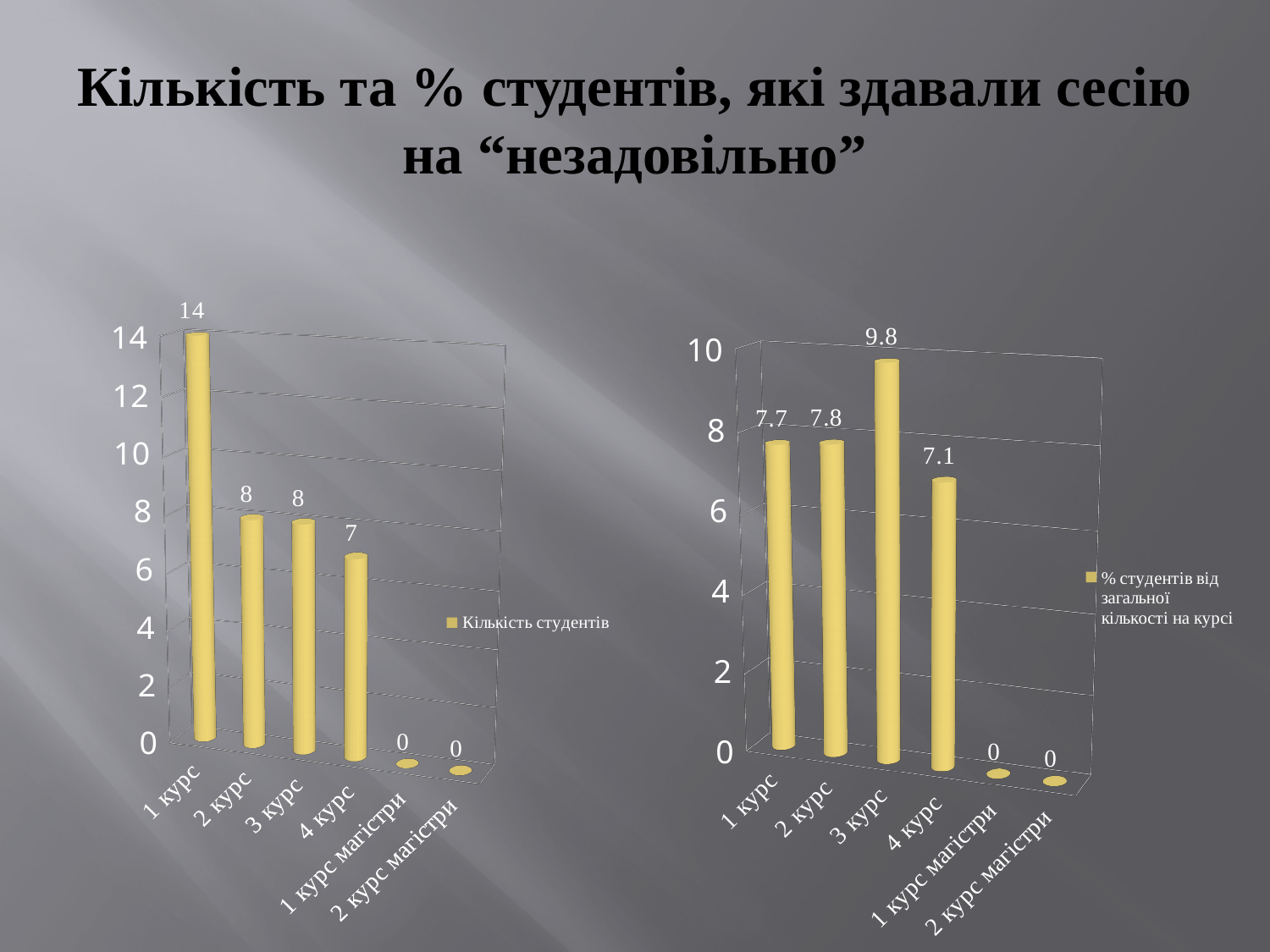
On the right chart, what is the difference between the values for 3 курс and 4 курс? 2.7 On the left chart, what is the value for 1 курс? 14 On the left chart, what is the difference between the values for 1 курс and 2 курс? 6 What is the legend entry on the left chart? Кількість студентів On the right chart, which of the first four courses has the highest value? 3 курс On the left chart, which category has the highest value? 1 курс On the left chart, how many categories are shown on the x axis? 6 What kind of chart is the left chart? Bar chart On the right chart, which is larger, the value for 2 курс or the value for 4 курс? 2 курс On the left chart, what is the value for 4 курс? 7 On the right chart, what is the value for 3 курс? 9.8 On the right chart, what is the value for 1 курс? 7.7